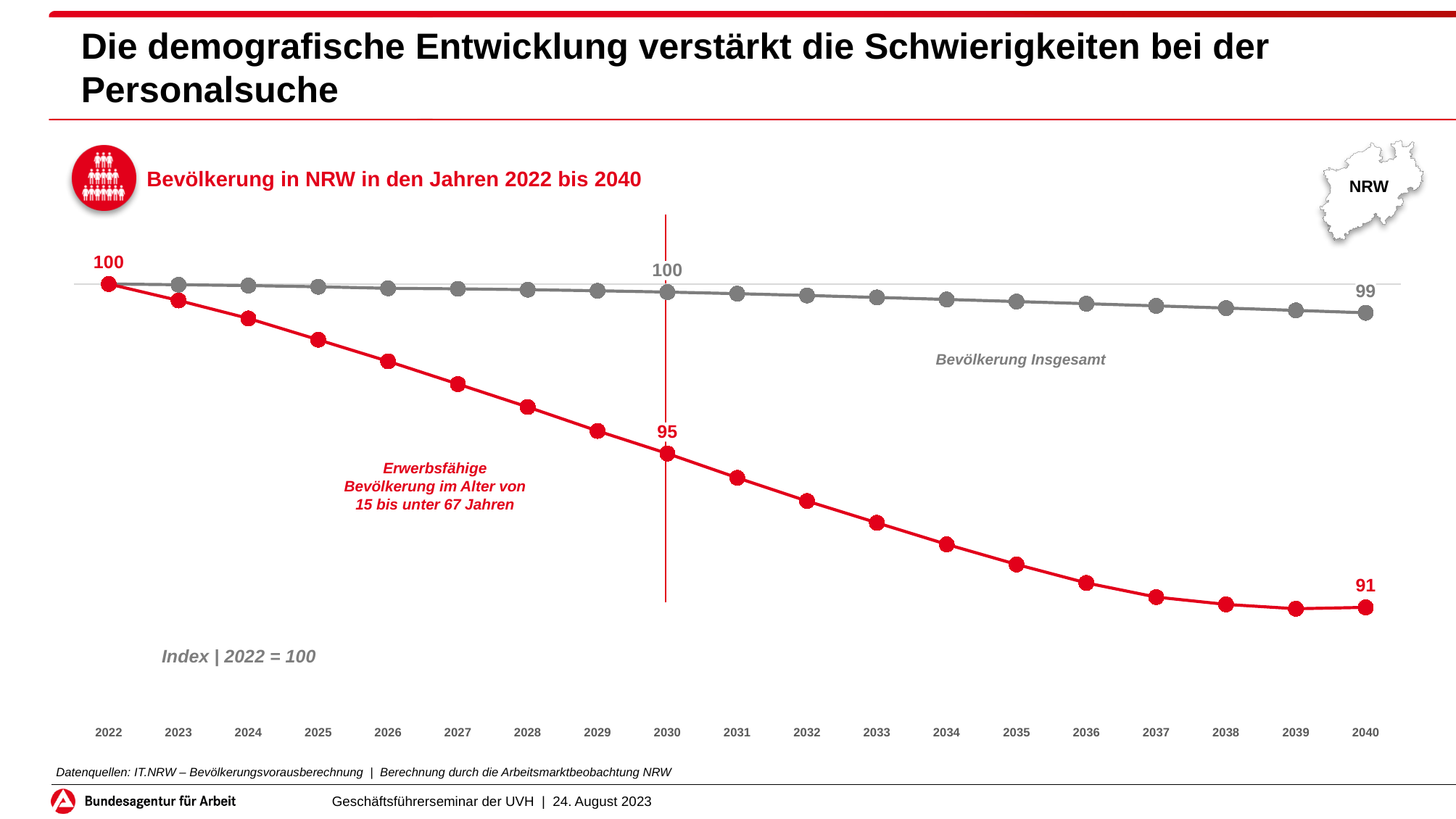
By how much does the Erwerbsfähige Bevölkerung index fall from 2022 to 2040? 9 What is the index value of the Erwerbsfähige Bevölkerung im Alter von 15 bis unter 67 Jahren series in 2040? 91 Which series has the higher value in 2040, Bevölkerung Insgesamt or Erwerbsfähige Bevölkerung im Alter von 15 bis unter 67 Jahren? Bevölkerung Insgesamt What is the difference between the Bevölkerung Insgesamt and the Erwerbsfähige Bevölkerung values in 2040? 8 What is the index value of the Bevölkerung Insgesamt series in 2030? 100 How many series are plotted in the chart? 2 What is the index value of the Erwerbsfähige Bevölkerung im Alter von 15 bis unter 67 Jahren series in 2030? 95 Does the Erwerbsfähige Bevölkerung im Alter von 15 bis unter 67 Jahren series rise or fall from 2022 to 2040? fall What is the index value of the Bevölkerung Insgesamt series in 2040? 99 What is the title of the chart? Bevölkerung in NRW in den Jahren 2022 bis 2040 What type of chart is shown on the slide? line chart How many years are shown on the x axis of the chart? 19